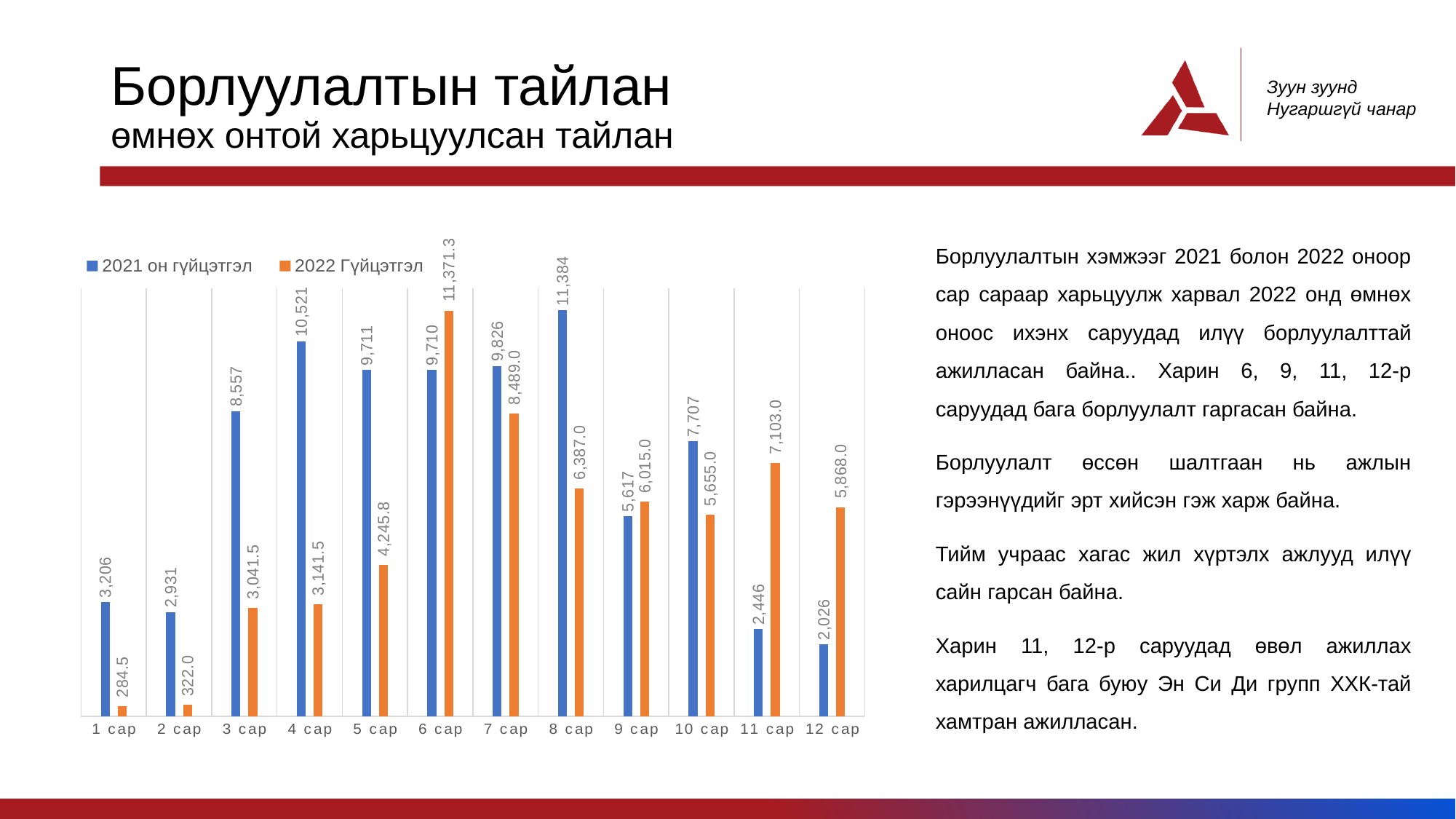
What type of chart is shown on the slide? bar chart Which month has the highest value for 2021 он гүйцэтгэл? 8 сар How many series does the chart legend list? 2 What is the value for 2022 Гүйцэтгэл in 1 сар? 284.5 In 8 сар, which series has the larger value: 2021 он гүйцэтгэл or 2022 Гүйцэтгэл? 2021 он гүйцэтгэл What is the value for 2021 он гүйцэтгэл in 4 сар? 10,521 What is the difference between the 2021 он гүйцэтгэл and 2022 Гүйцэтгэл values in 11 сар? 4,657.0 How many months (categories) are shown on the x axis of the chart? 12 What is the value for 2022 Гүйцэтгэл in 6 сар? 11,371.3 What colour are the bars for the 2022 Гүйцэтгэл series? orange Which month has the lowest value for 2021 он гүйцэтгэл? 12 сар Which month has the lowest value for 2022 Гүйцэтгэл? 1 сар